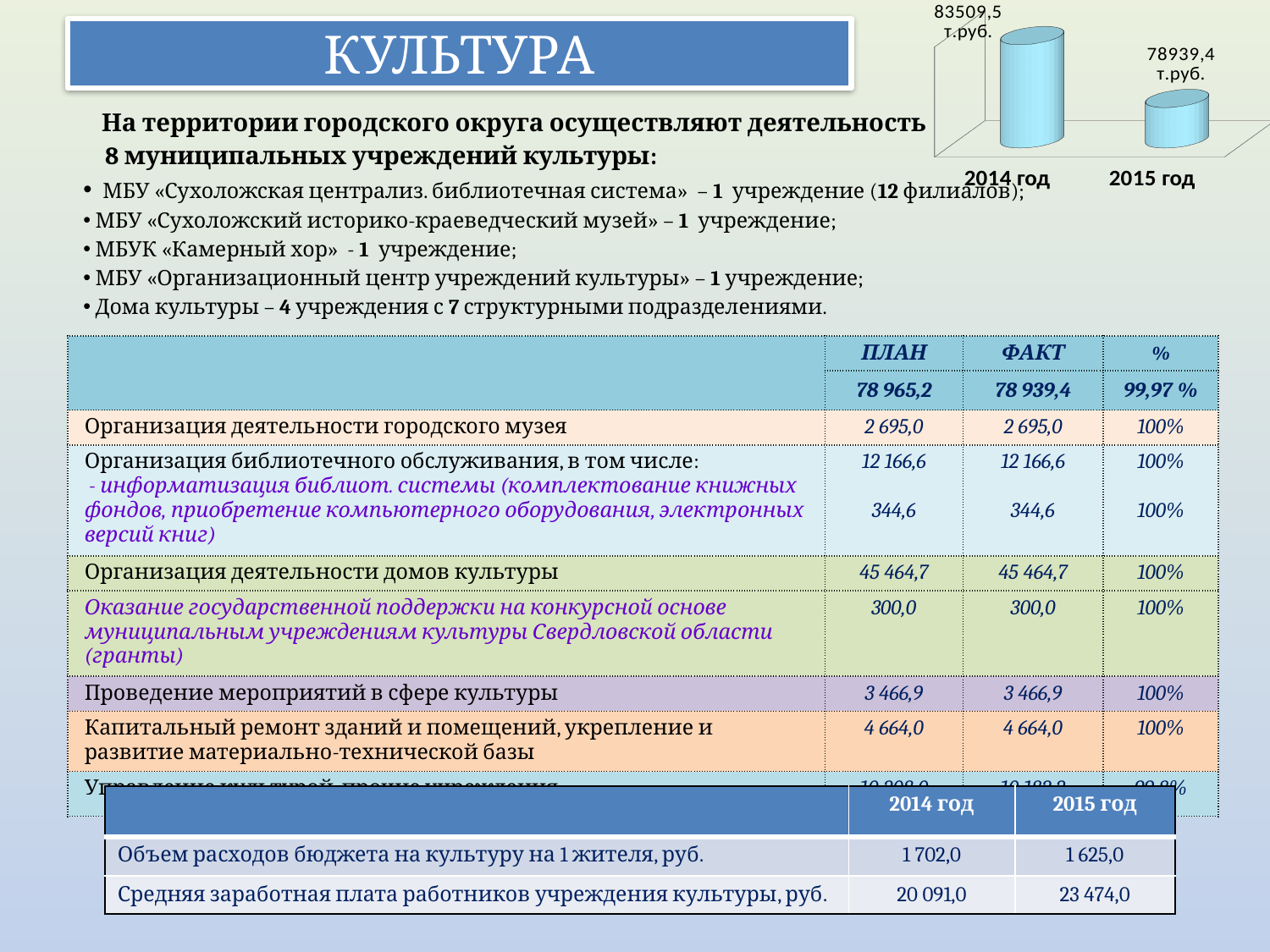
By how much does the value for 2014 год exceed the value for 2015 год in the chart? 4570,1 т.руб. What value is shown for 2014 год in the chart? 83509,5 т.руб. What value is shown for 2015 год in the chart? 78939,4 т.руб. Which year has the higher value in the chart? 2014 год What kind of chart is shown in the top right of the slide? Bar chart Does the value rise or fall from 2014 год to 2015 год in the chart? Fall Which year has the lower value in the chart? 2015 год Which is larger in the chart: the value for 2014 год or for 2015 год? 2014 год In what unit are the values in the chart labelled? т.руб. How many bars (categories) does the chart show? 2